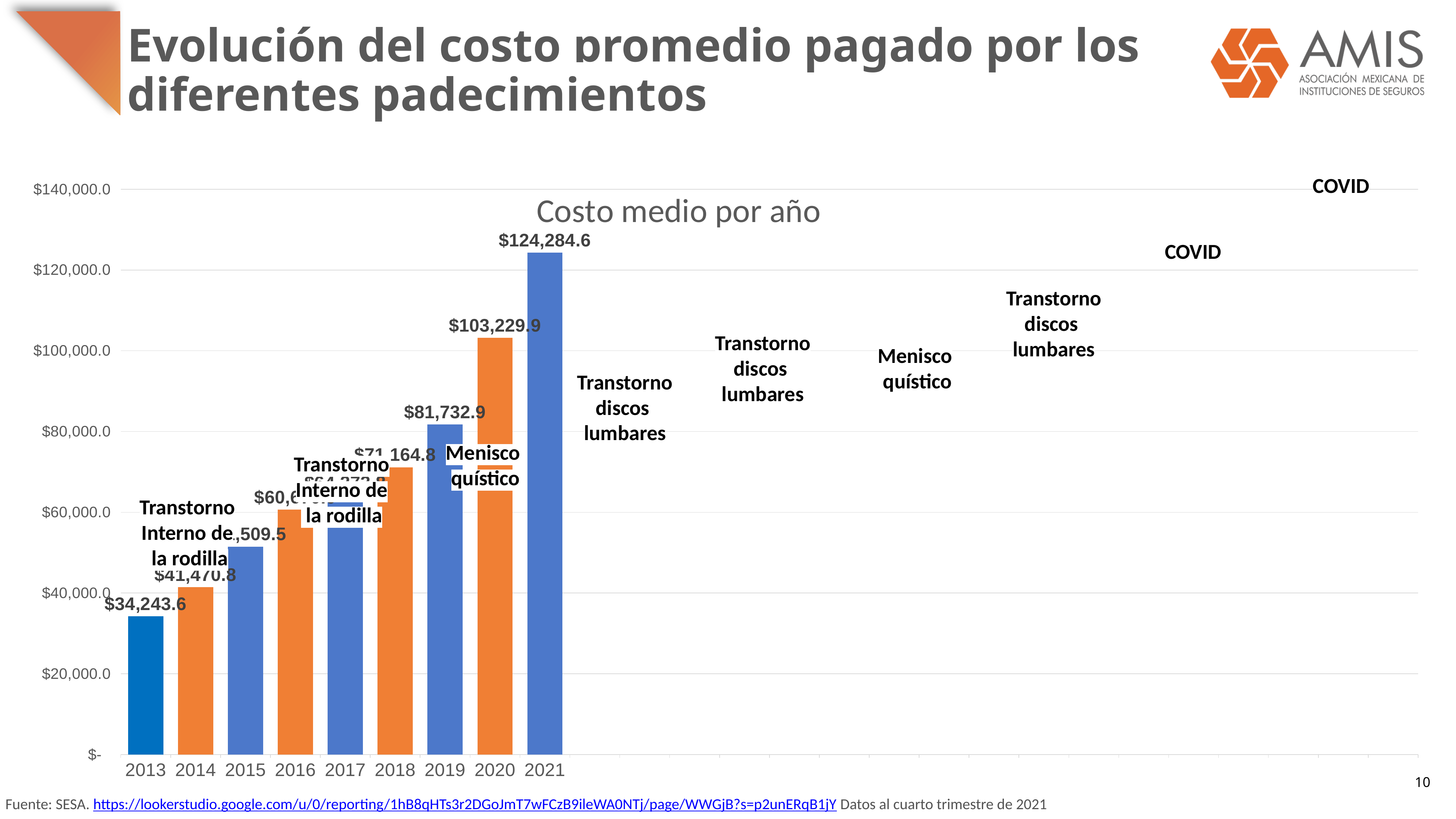
In the chart 'Costo medio por año', what is the difference between the values for 2021 and 2020? $21,054.7 In the chart 'Costo medio por año', is the value for 2018 greater or less than $80,000.0? less In the chart 'Costo medio por año', which year has the lowest value? 2013 In the chart 'Costo medio por año', which year has the highest value? 2021 In the chart 'Costo medio por año', what is the value for 2013? $34,243.6 In the chart 'Costo medio por año', what is the value for 2020? $103,229.9 In the chart 'Costo medio por año', what is the value for 2014? $41,470.8 In the chart 'Costo medio por año', which is larger, the value for 2019 or the value for 2020? 2020 What kind of chart is 'Costo medio por año'? bar chart In the chart 'Costo medio por año', what is the value for 2019? $81,732.9 How many years are shown on the x axis of the chart 'Costo medio por año'? 9 In the chart 'Costo medio por año', what is the value for 2021? $124,284.6